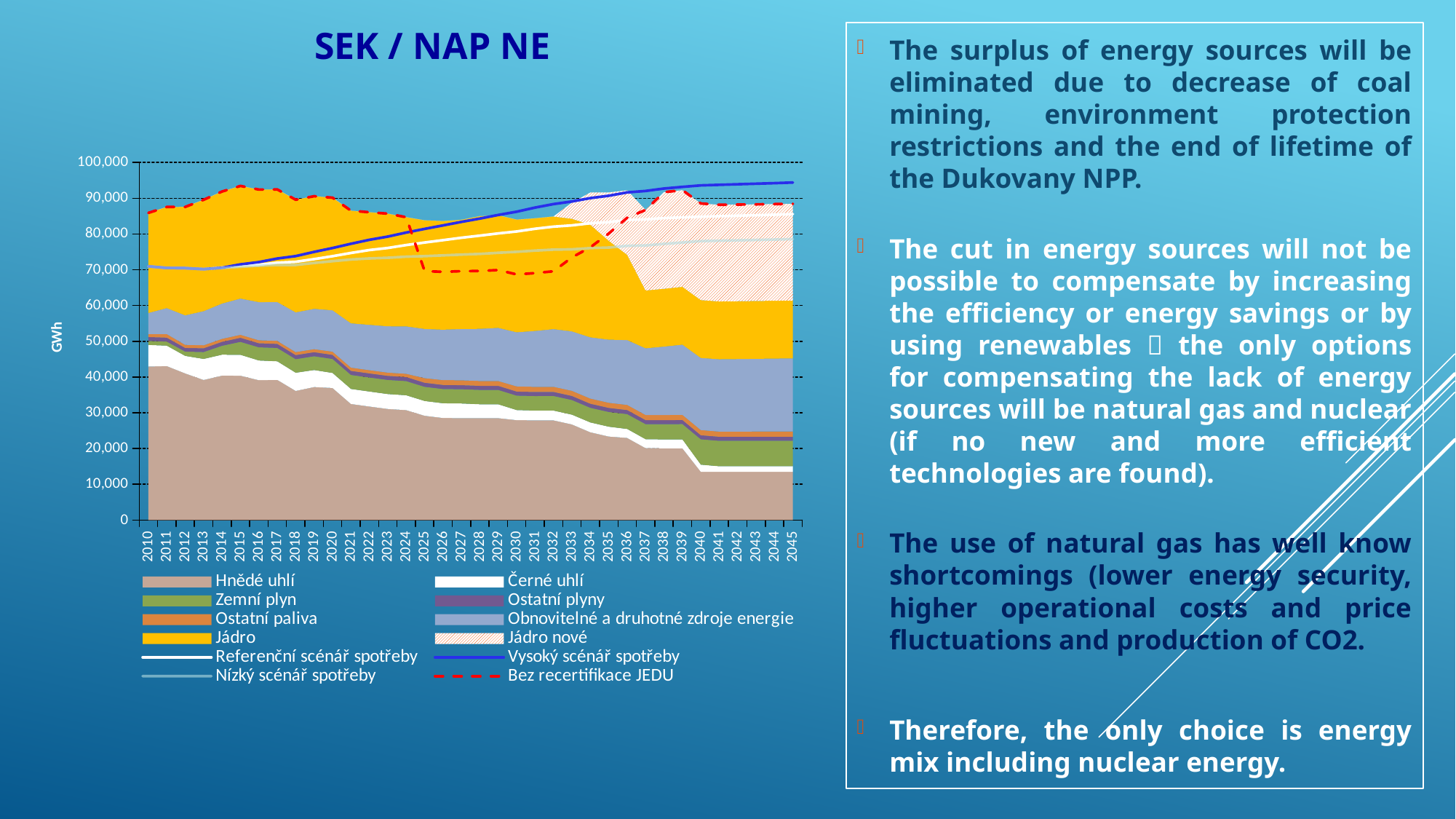
What unit is shown on the y axis of the chart? GWh What kind of chart is shown on the slide? Stacked area chart with line series In 2045, which is larger: Vysoký scénář spotřeby or Nízký scénář spotřeby? Vysoký scénář spotřeby Does the Hnědé uhlí area rise or fall from 2010 to 2045? Fall Is the value for Hnědé uhlí in 2045 greater or less than 20,000? less What is the last year shown on the x axis? 2045 Does the Vysoký scénář spotřeby line rise or fall from 2010 to 2045? Rise What is the first year shown on the x axis? 2010 What is the highest value shown on the y axis? 100,000 How many years are shown along the x axis of the chart? 36 How many series does the chart legend list? 12 Is the value for Hnědé uhlí in 2010 greater or less than 40,000? greater